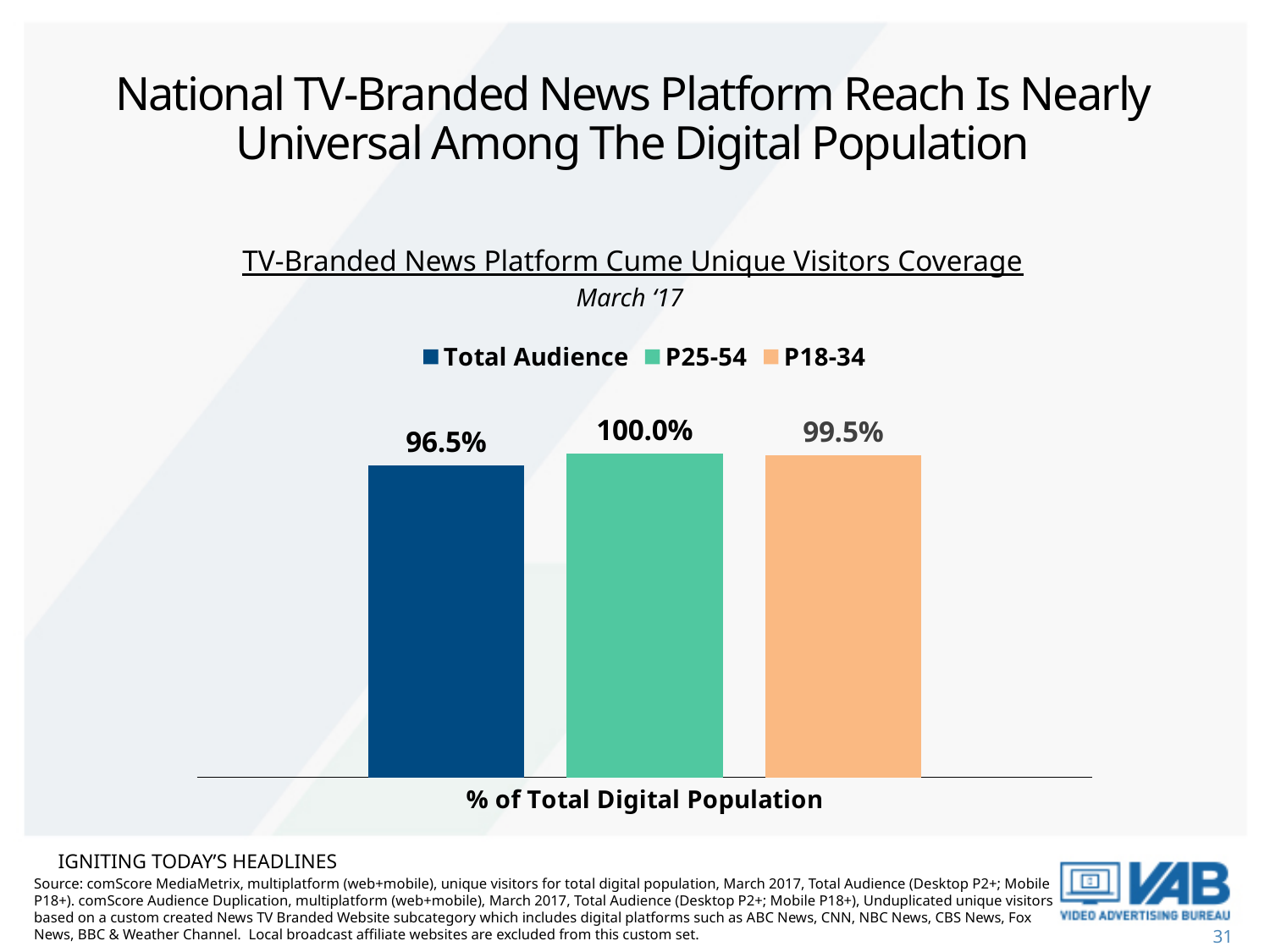
What is the value for P25-54? 100.0% Which series has the lowest value? Total Audience What is the label shown below the bars on the x axis? % of Total Digital Population How many series does the legend list? 3 What is the title of the chart? TV-Branded News Platform Cume Unique Visitors Coverage What is the difference between the P25-54 value and the Total Audience value? 3.5% What kind of chart is shown on the slide? Bar chart Which is larger, the value for Total Audience or the value for P18-34? P18-34 What is the difference between the P18-34 value and the Total Audience value? 3.0% Which series has the highest value? P25-54 What is the value for P18-34? 99.5% What is the value for Total Audience? 96.5%